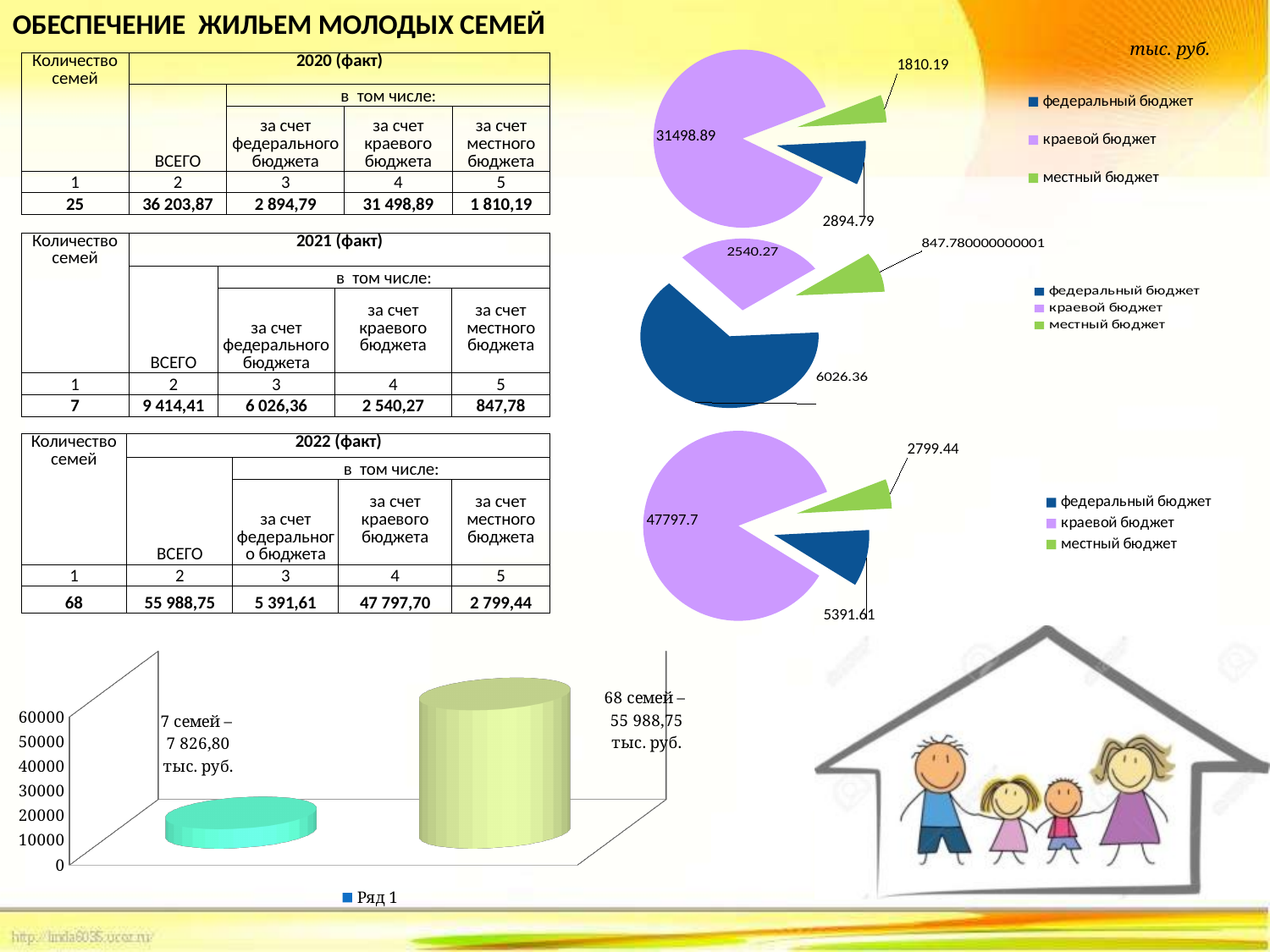
How many entries does the legend of each pie chart list? 3 In the middle pie chart on the right, what is the difference between the федеральный бюджет value (6026.36) and the краевой бюджет value (2540.27)? 3486.09 In the top pie chart on the right, what value is shown for the largest slice (краевой бюджет)? 31498.89 In the top pie chart on the right, what value is labelled on the местный бюджет slice? 1810.19 In the top pie chart on the right, which budget category has the largest slice? краевой бюджет In the bar chart at the bottom left, what series name does the legend show? Ряд 1 In the middle pie chart on the right, which budget category has the smallest slice? местный бюджет What kind of chart is shown at the bottom left of the slide? bar chart In the middle pie chart on the right, what value is shown for the федеральный бюджет slice? 6026.36 In the bar chart at the bottom left, is the value for the bar labelled '68 семей' greater or less than 50000? greater In the bottom pie chart on the right, what value is labelled on the краевой бюджет slice? 47797.7 In the bottom pie chart on the right, which is larger: the федеральный бюджет slice or the местный бюджет slice? федеральный бюджет